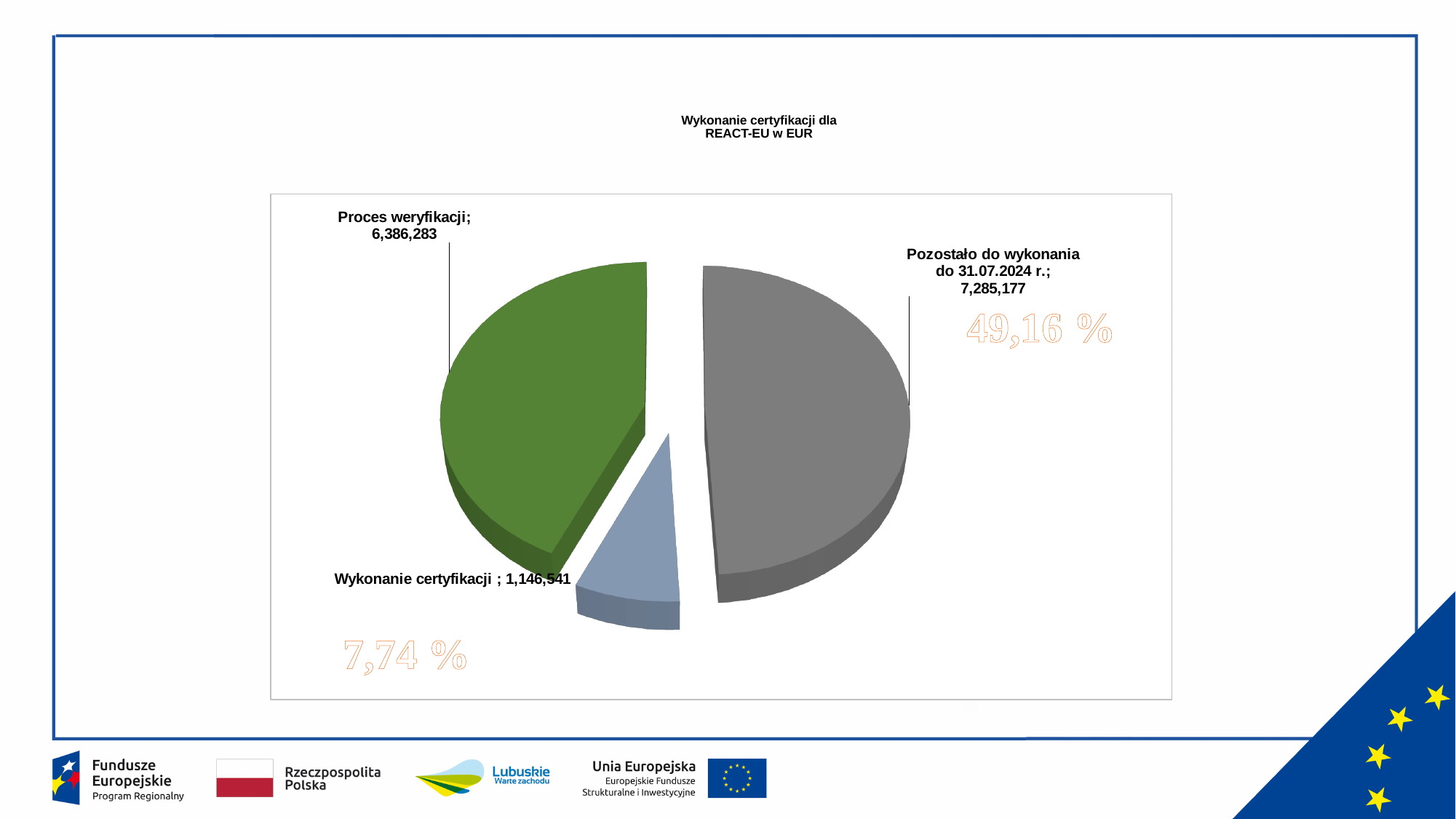
How many slices does the pie chart have? 3 Which category has the largest slice of the pie? Pozostało do wykonania do 31.07.2024 r. What is the title of the chart? Wykonanie certyfikacji dla REACT-EU w EUR What is the difference between the values for Pozostało do wykonania do 31.07.2024 r. and Proces weryfikacji? 898,894 Which category has the smallest slice of the pie? Wykonanie certyfikacji What kind of chart is shown on the slide? Pie chart Which is larger, the value for Proces weryfikacji or the value for Wykonanie certyfikacji? Proces weryfikacji What is the value for Wykonanie certyfikacji? 1,146,541 What is the difference between the values for Proces weryfikacji and Wykonanie certyfikacji? 5,239,742 What percentage share of the pie is shown for Pozostało do wykonania do 31.07.2024 r.? 49,16 % What is the value for Proces weryfikacji? 6,386,283 What is the value for Pozostało do wykonania do 31.07.2024 r.? 7,285,177